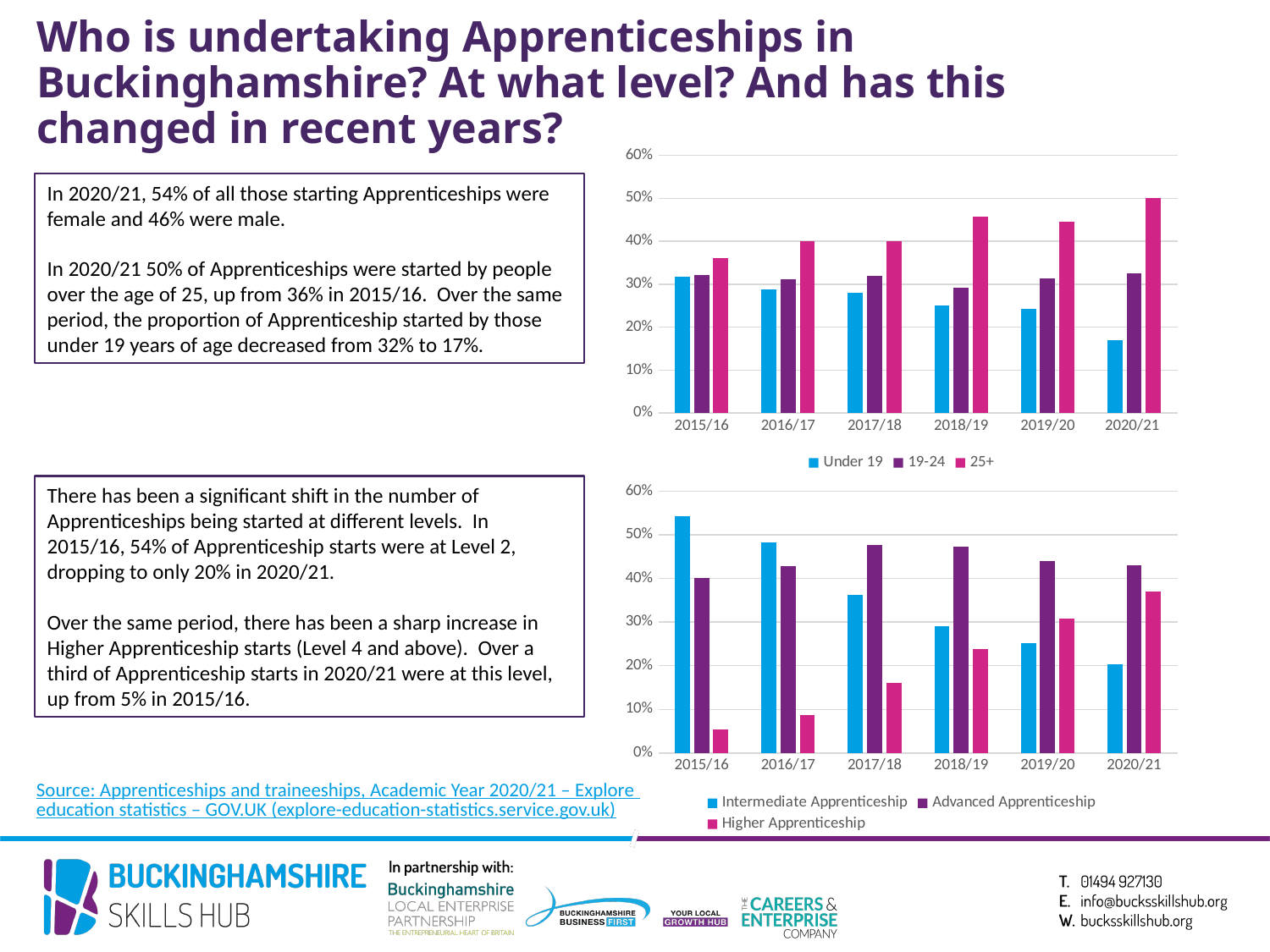
How many academic years are shown on the x axis of the top chart? 6 In the top chart, which year has the highest value for the 25+ series? 2020/21 In the top chart, what is the value for 25+ in 2020/21? 50% How many series does the legend of the top chart list? 3 In the top chart, does the Under 19 series rise or fall from 2015/16 to 2020/21? Fall In the top chart, which is larger in 2015/16: Under 19 or 25+? 25+ What type of chart is the top chart on the slide? Bar chart In the bottom chart, which year has the lowest value for Intermediate Apprenticeship? 2020/21 In the top chart, is the value for Under 19 in 2020/21 greater or less than 20%? less In the bottom chart, which is larger in 2020/21: Advanced Apprenticeship or Higher Apprenticeship? Advanced Apprenticeship In the bottom chart, is the value for Higher Apprenticeship in 2020/21 greater or less than 30%? greater In the bottom chart, which year has the highest value for Intermediate Apprenticeship? 2015/16